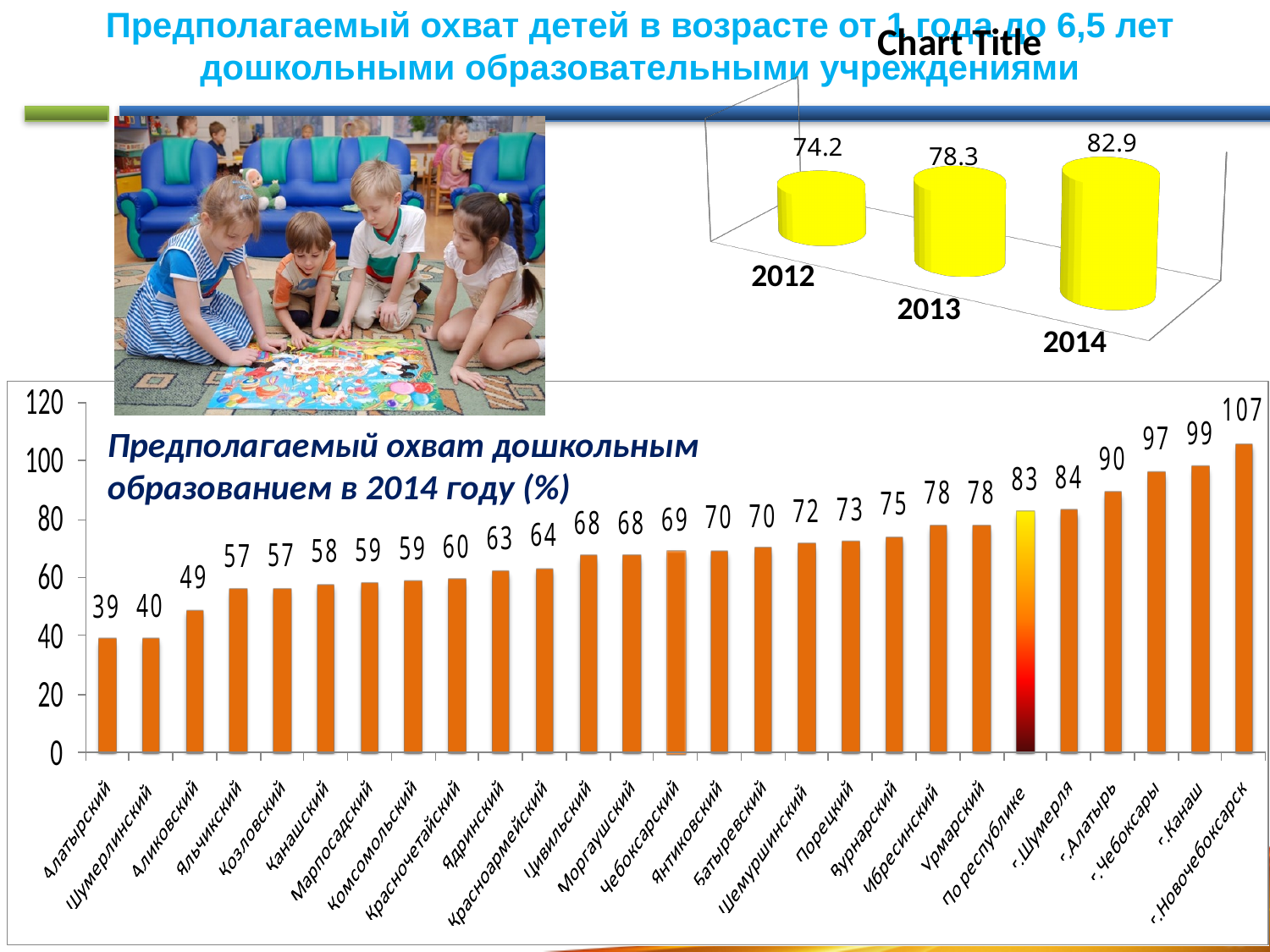
In the top-right chart titled "Chart Title", do the values rise or fall from 2012 to 2014? rise In the bottom chart "Предполагаемый охват дошкольным образованием в 2014 году (%)", which is larger, Порецкий or Вурнарский? Вурнарский In the top-right chart titled "Chart Title", what is the value for 2012? 74.2 In the bottom chart "Предполагаемый охват дошкольным образованием в 2014 году (%)", what is the value for г.Новочебоксарск? 107 In the top-right chart titled "Chart Title", what is the value for 2014? 82.9 In the top-right chart titled "Chart Title", how many years are plotted? 3 In the top-right chart titled "Chart Title", what is the difference between the 2014 and 2012 values? 8.7 In the bottom chart "Предполагаемый охват дошкольным образованием в 2014 году (%)", which category has the lowest value? Алатырский In the bottom chart "Предполагаемый охват дошкольным образованием в 2014 году (%)", what is the value for По республике? 83 In the bottom chart "Предполагаемый охват дошкольным образованием в 2014 году (%)", which category has the highest value? г.Новочебоксарск What kind of chart is the bottom chart "Предполагаемый охват дошкольным образованием в 2014 году (%)"? bar chart In the bottom chart "Предполагаемый охват дошкольным образованием в 2014 году (%)", what is the difference between г.Канаш and Аликовский? 50